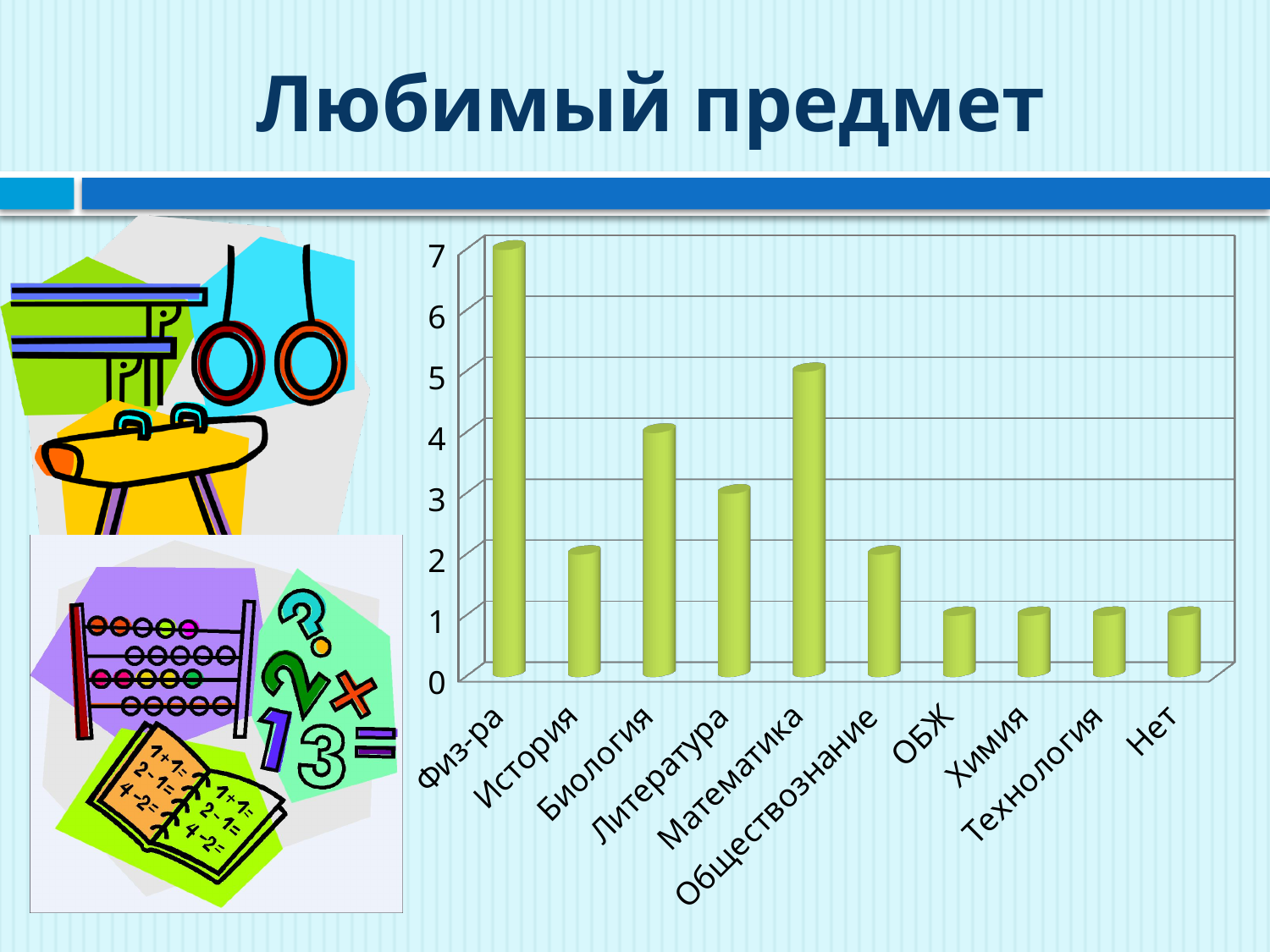
What is the title of the slide containing the chart? Любимый предмет Which category has the highest value? Физ-ра Is the value for История greater or less than 4? less What type of chart is shown on the slide? bar chart What is the value for ОБЖ? 1 What is the value for Литература? 3 What is the value for Физ-ра? 7 What is the difference between the values for Физ-ра and Математика? 2 What is the value for Математика? 5 What is the value for Биология? 4 Which is larger, the value for Биология or the value for Литература? Биология How many categories are shown on the x axis? 10